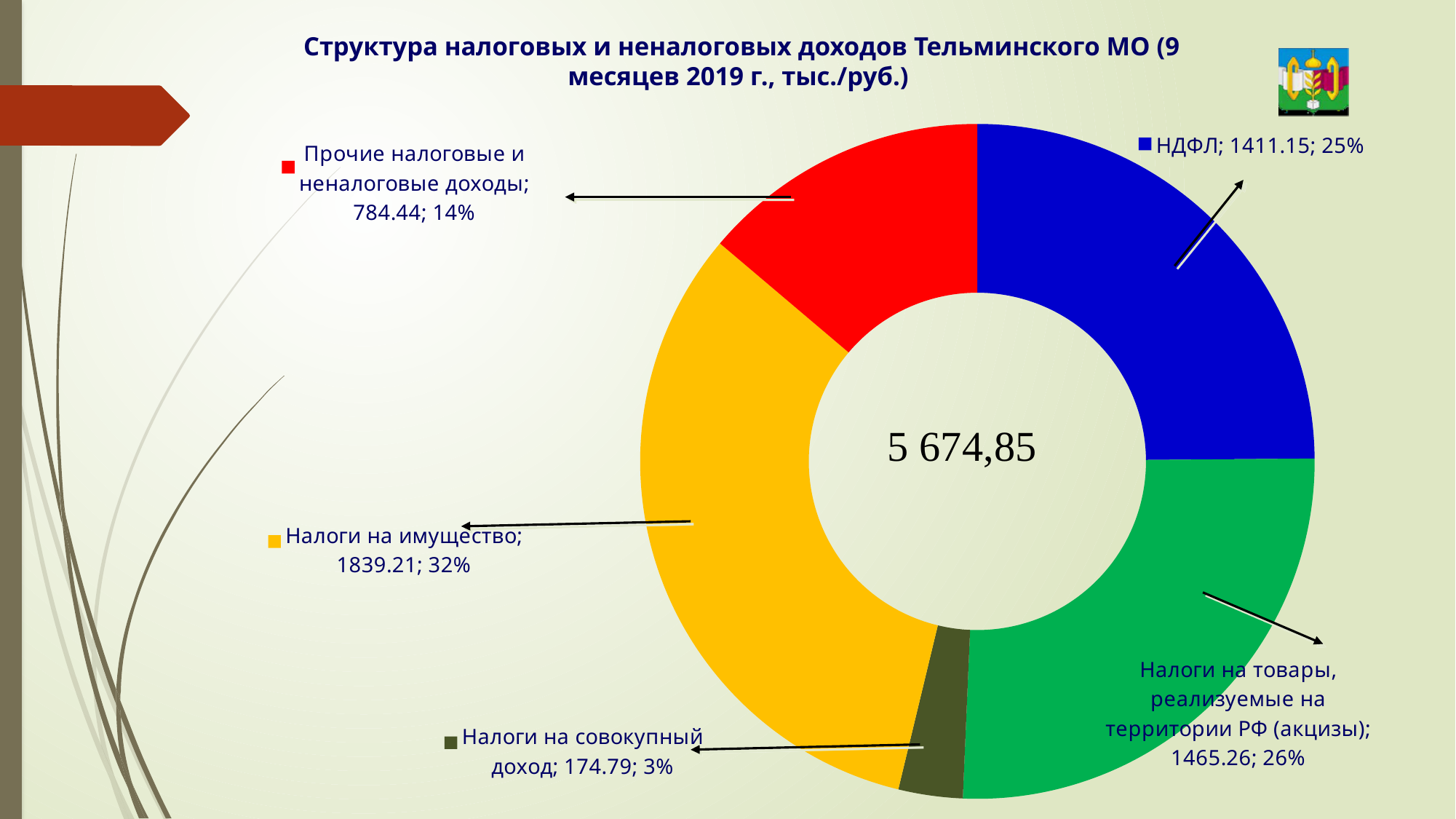
What share of the total do Налоги на товары, реализуемые на территории РФ (акцизы) represent? 26% Which category has the largest value? Налоги на имущество What is the value for Налоги на совокупный доход? 174.79 What total is printed in the centre of the doughnut chart? 5 674,85 Which category has the smallest value? Налоги на совокупный доход What is the difference between the values for Налоги на имущество and НДФЛ? 428.06 What is the value for Налоги на имущество? 1839.21 What kind of chart is shown on the slide? Doughnut (pie) chart What share of the total do Прочие налоговые и неналоговые доходы represent? 14% Which is larger: the value for Налоги на имущество or the value for Прочие налоговые и неналоговые доходы? Налоги на имущество What is the value for НДФЛ? 1411.15 How many slices does the chart have? 5